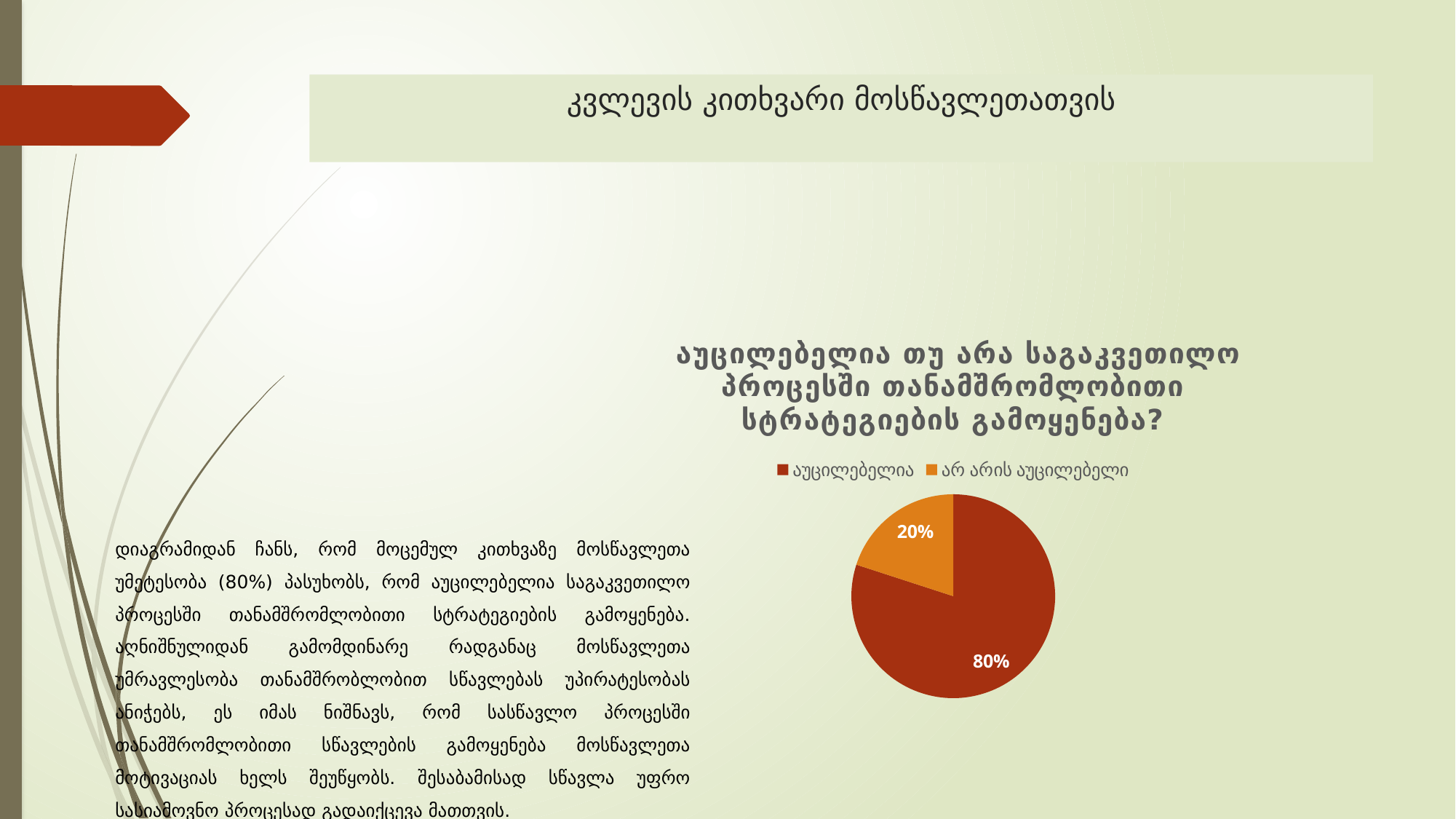
Which slice of the pie chart is the smallest? არ არის აუცილებელი What kind of chart is shown on the slide? pie chart What is the difference in percentage points between the "აუცილებელია" slice and the "არ არის აუცილებელი" slice? 60 Which slice of the pie chart is the largest? აუცილებელია What share of the pie does the slice "არ არის აუცილებელი" represent? 20% What is the title of the pie chart? აუცილებელია თუ არა საგაკვეთილო პროცესში თანამშრომლობითი სტრატეგიების გამოყენება? How many slices does the pie chart have? 2 What colour is the "არ არის აუცილებელი" slice in the pie chart? orange What share of the pie does the slice "აუცილებელია" represent? 80% How many entries does the legend of the pie chart list? 2 Which is larger: the "აუცილებელია" slice or the "არ არის აუცილებელი" slice? აუცილებელია